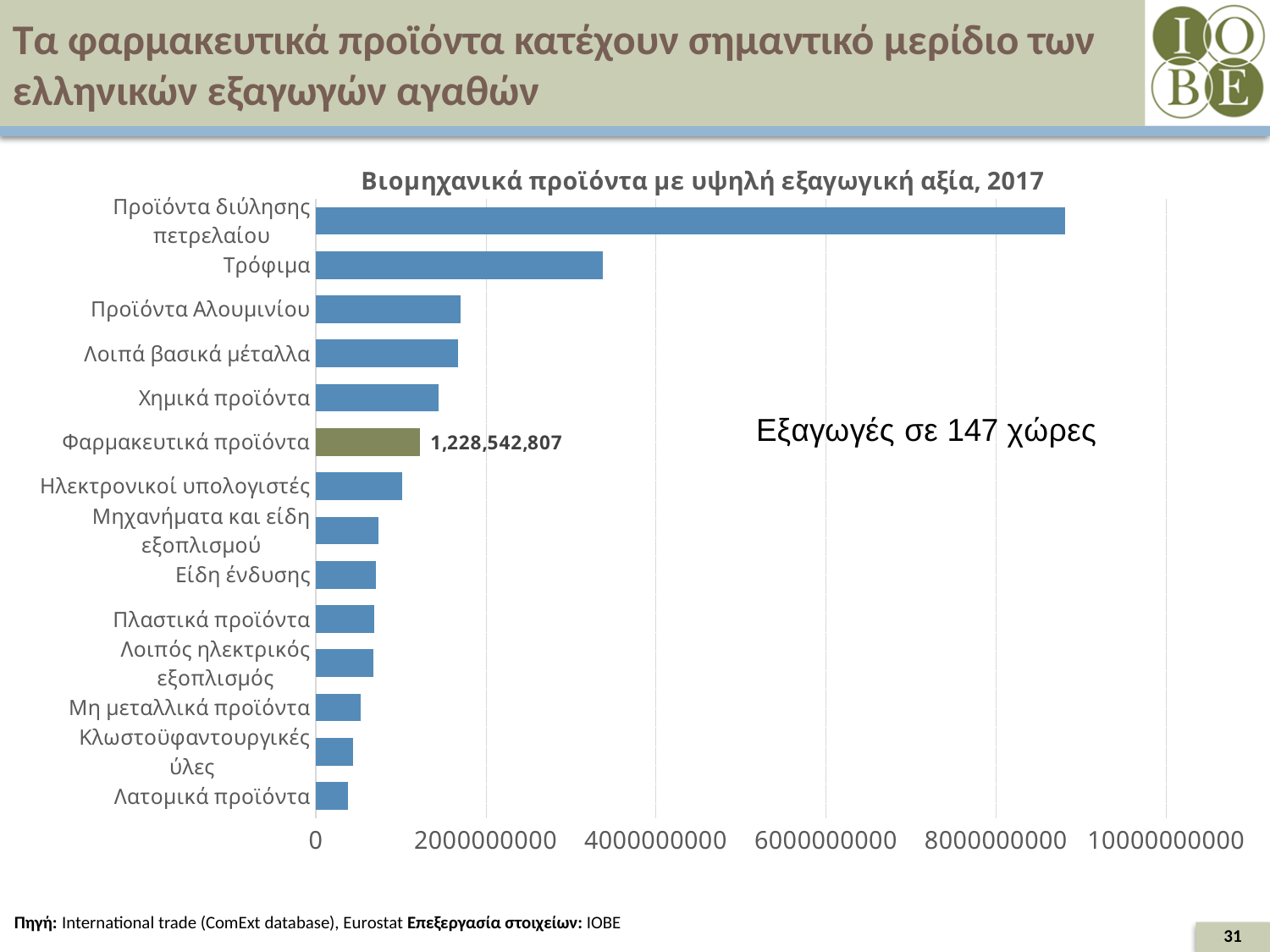
Which category has the highest export value in the chart? Προϊόντα διύλησης πετρελαίου What is the value shown for Φαρμακευτικά προϊόντα? 1,228,542,807 What kind of chart is shown on the slide? Bar chart Which category has the lowest export value in the chart? Λατομικά προϊόντα Is the value for Προϊόντα Αλουμινίου greater or less than 2000000000? less Which has a larger export value, Τρόφιμα or Προϊόντα Αλουμινίου? Τρόφιμα Which has a larger export value, Ηλεκτρονικοί υπολογιστές or Λατομικά προϊόντα? Ηλεκτρονικοί υπολογιστές Is the value for Προϊόντα διύλησης πετρελαίου greater or less than 8000000000? greater Which category's bar is coloured green instead of blue? Φαρμακευτικά προϊόντα How many product categories are shown in the chart? 14 Is the value for Τρόφιμα greater or less than 4000000000? less What is the title of the chart? Βιομηχανικά προϊόντα με υψηλή εξαγωγική αξία, 2017